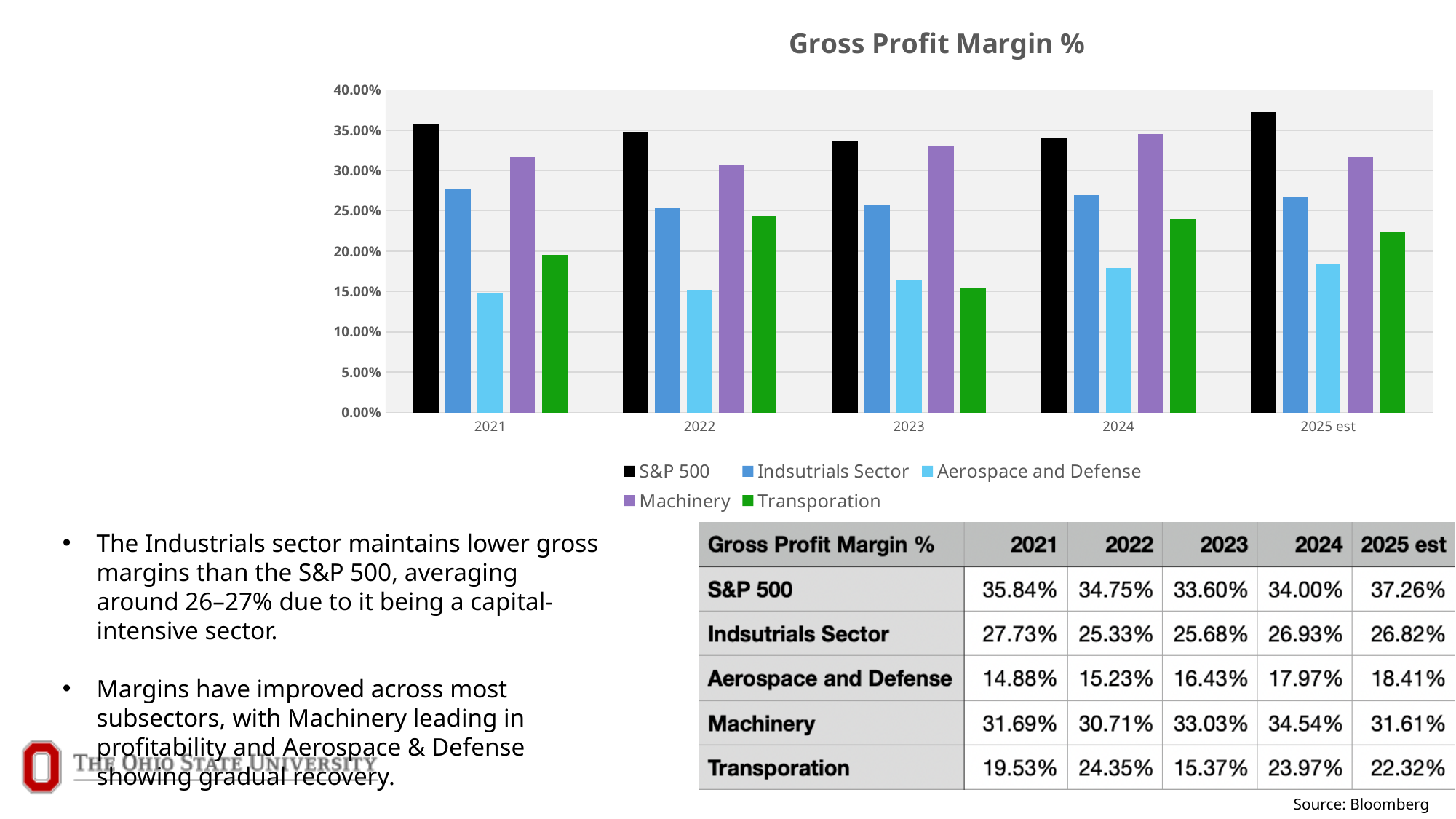
How many year categories are shown on the x axis of the chart? 5 What is the gross profit margin for the S&P 500 in 2025 est? 37.26% What is the difference between the S&P 500 and Indsutrials Sector gross profit margins in 2021? 8.11% What is the gross profit margin for Machinery in 2024? 34.54% What is the gross profit margin for Aerospace and Defense in 2021? 14.88% Which series has the highest gross profit margin in 2024? Machinery Does the Aerospace and Defense gross profit margin rise or fall from 2021 to 2025 est? rise What type of chart is shown on the slide? bar chart What colour are the Machinery bars in the chart? purple How many series does the legend of the Gross Profit Margin % chart list? 5 Which series has the lowest gross profit margin in 2023? Transporation Which is larger in 2022: the Transporation margin or the Indsutrials Sector margin? Indsutrials Sector